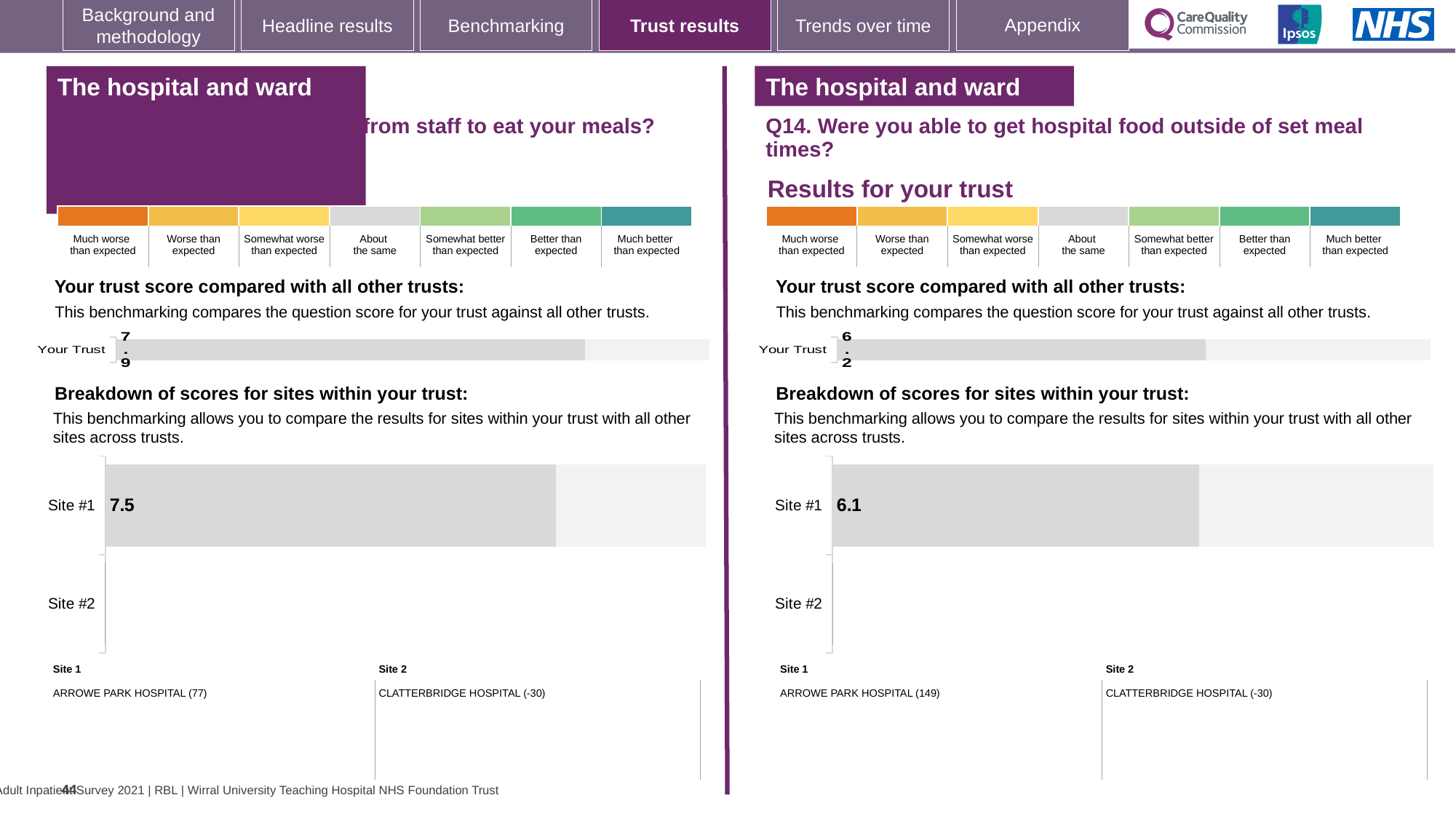
In the right-hand breakdown chart (Q14), which site has a bar plotted: Site #1 or Site #2? Site #1 In the left-hand breakdown of scores for sites within your trust, what is the score for Site #1? 7.5 On the left-hand chart (question about help from staff to eat your meals), what is the score shown for Your Trust? 7.9 On the left-hand side, what is the difference between the Your Trust score and the Site #1 score? 0.4 On the right-hand chart for Q14 (hospital food outside of set meal times), what is the score shown for Your Trust? 6.2 In the right-hand breakdown of scores for sites within your trust (Q14), what is the score for Site #1? 6.1 Which is larger: the Your Trust score on the left-hand chart or the Your Trust score on the right-hand chart (Q14)? Left-hand chart (7.9) On the right-hand side (Q14), what is the difference between the Your Trust score and the Site #1 score? 0.1 Which hospital is listed as Site 1 beneath the breakdown charts? ARROWE PARK HOSPITAL What is the difference between the Site #1 score on the left-hand breakdown chart and the Site #1 score on the right-hand breakdown chart (Q14)? 1.4 What kind of chart is used to show the breakdown of scores for sites within your trust? Bar chart How many sites are listed in the right-hand breakdown of scores for sites within your trust (Q14)? 2